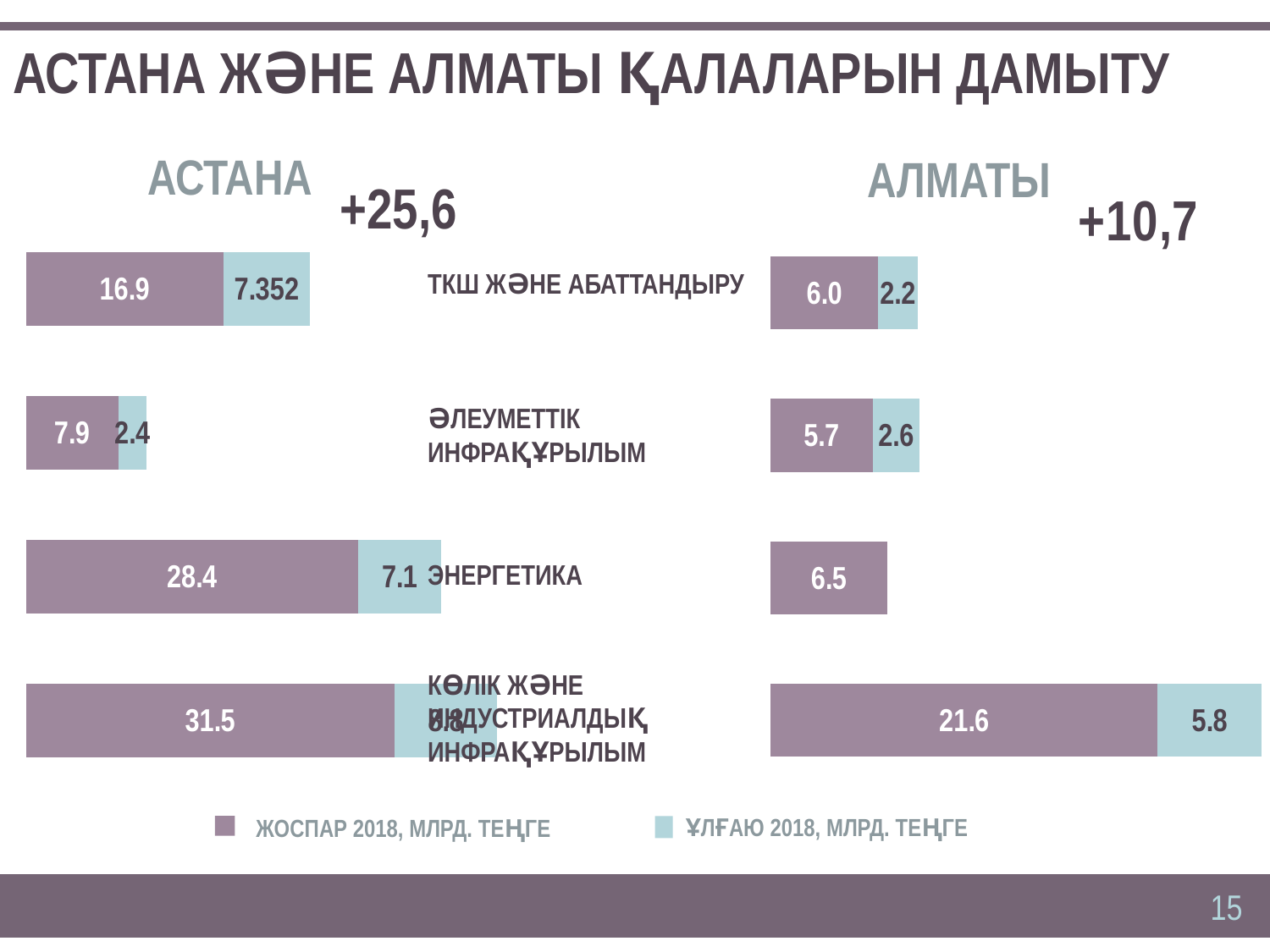
On the АСТАНА chart, what is the difference between the ЖОСПАР 2018 values for ЭНЕРГЕТИКА and ӘЛЕУМЕТТІК ИНФРАҚҰРЫЛЫМ? 20.5 On the АЛМАТЫ chart, what is the ЖОСПАР 2018 value for ЭНЕРГЕТИКА? 6.5 On the АСТАНА chart, what is the ҰЛҒАЮ 2018 value for ТКШ ЖӘНЕ АБАТТАНДЫРУ? 7.352 On the АЛМАТЫ chart, what is the total of the stacked bar for ТКШ ЖӘНЕ АБАТТАНДЫРУ? 8.2 On the АСТАНА chart, what is the ЖОСПАР 2018 value for ТКШ ЖӘНЕ АБАТТАНДЫРУ? 16.9 What kind of chart is the АСТАНА chart? Bar chart On the АЛМАТЫ chart, which category has the lowest ЖОСПАР 2018 value? ӘЛЕУМЕТТІК ИНФРАҚҰРЫЛЫМ On the АСТАНА chart, which category has the highest ЖОСПАР 2018 value? КӨЛІК ЖӘНЕ ИНДУСТРИАЛДЫҚ ИНФРАҚҰРЫЛЫМ How many series does the legend list for the charts? 2 Which is larger: the ЖОСПАР 2018 value for ТКШ ЖӘНЕ АБАТТАНДЫРУ on the АСТАНА chart or on the АЛМАТЫ chart? АСТАНА On the АСТАНА chart, which category has the lowest ЖОСПАР 2018 value? ӘЛЕУМЕТТІК ИНФРАҚҰРЫЛЫМ On the АЛМАТЫ chart, what is the ҰЛҒАЮ 2018 value for КӨЛІК ЖӘНЕ ИНДУСТРИАЛДЫҚ ИНФРАҚҰРЫЛЫМ? 5.8